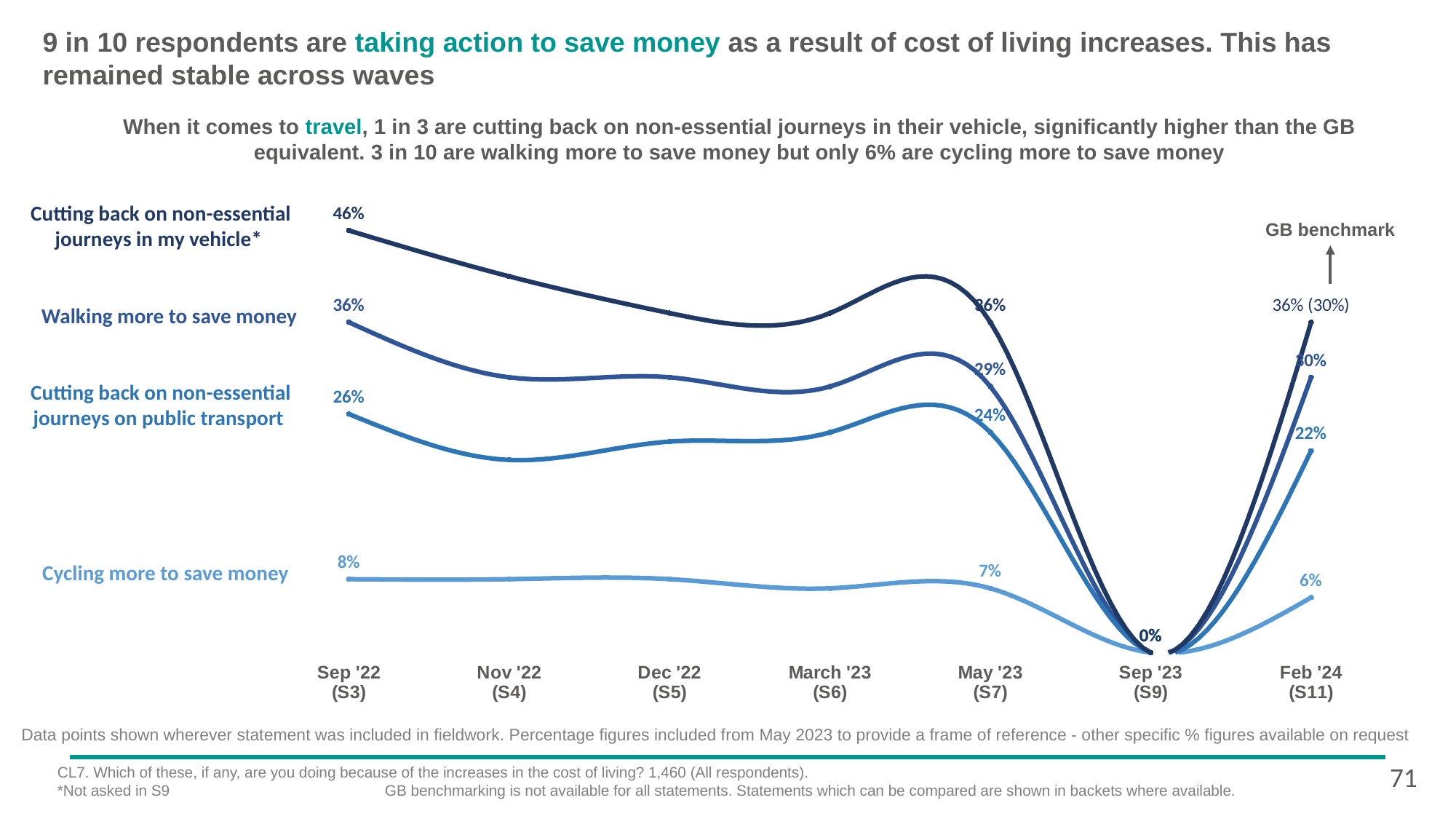
What is the value for 'Cycling more to save money' at Feb '24 (S11)? 6% What is the value for 'Walking more to save money' at Sep '22 (S3)? 36% How many series are plotted on the chart? 4 How many time points are shown on the x axis? 7 What is the value for 'Cutting back on non-essential journeys on public transport' at Feb '24 (S11)? 22% Which series has the highest value at Sep '22 (S3)? Cutting back on non-essential journeys in my vehicle At Sep '22 (S3), what is the difference between 'Cutting back on non-essential journeys in my vehicle' and 'Walking more to save money'? 10 percentage points Which series has the lowest value at Feb '24 (S11)? Cycling more to save money Is the value for 'Cutting back on non-essential journeys on public transport' higher at Sep '22 (S3) or at May '23 (S7)? Sep '22 (S3) What is the value for 'Cutting back on non-essential journeys in my vehicle' at Sep '22 (S3)? 46% What is the value for 'Cycling more to save money' at May '23 (S7)? 7% What kind of chart is shown on the slide? Line chart